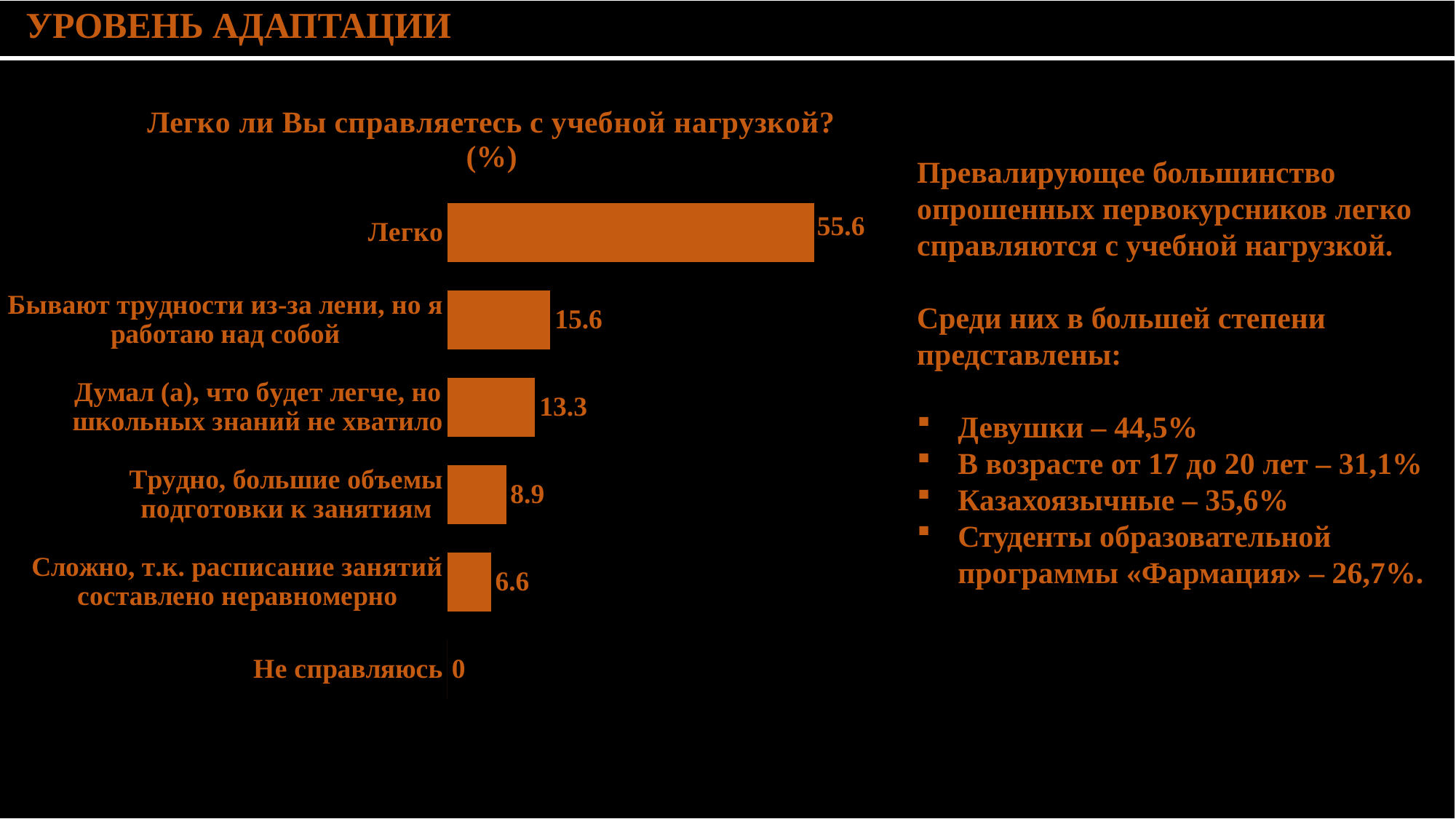
What is the value for "Думал (а), что будет легче, но школьных знаний не хватило"? 13.3 Which category has the lowest value? Не справляюсь What is the value for "Легко"? 55.6 What is the difference between the values for "Легко" and "Бывают трудности из-за лени, но я работаю над собой"? 40 How many categories are shown in the chart? 6 Which is larger: the value for "Трудно, большие объемы подготовки к занятиям" or for "Сложно, т.к. расписание занятий составлено неравномерно"? Трудно, большие объемы подготовки к занятиям What is the value for "Трудно, большие объемы подготовки к занятиям"? 8.9 What is the value for "Не справляюсь"? 0 What is the value for "Сложно, т.к. расписание занятий составлено неравномерно"? 6.6 What is the value for "Бывают трудности из-за лени, но я работаю над собой"? 15.6 Which category has the highest value? Легко What type of chart is shown on the slide? Bar chart